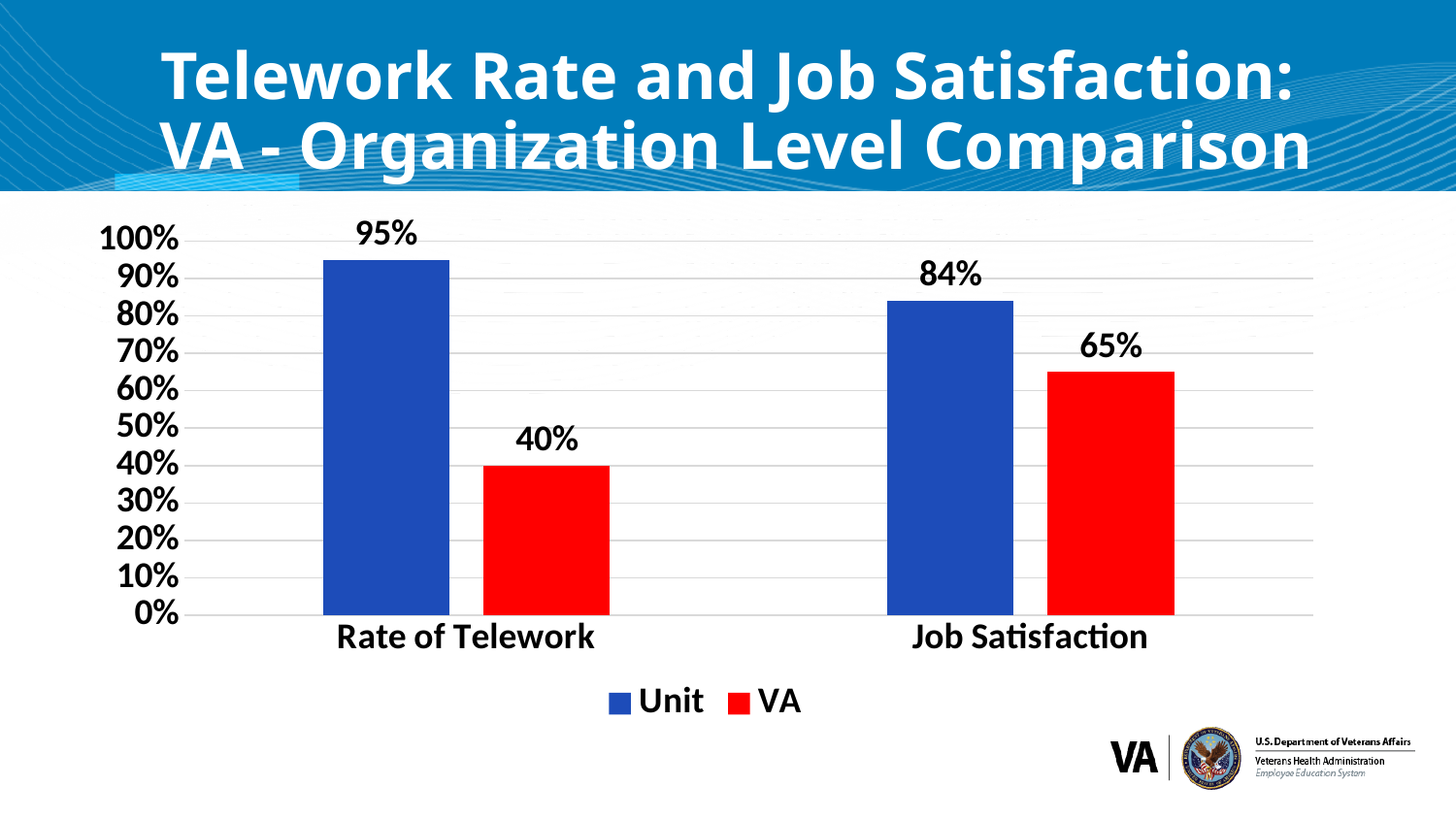
How many categories are shown on the x axis? 2 What is the difference between the Unit and VA values for Job Satisfaction? 19% What is the difference between the Unit and VA values for Rate of Telework? 55% What is the Unit value for Rate of Telework? 95% What is the VA value for Job Satisfaction? 65% What is the Unit value for Job Satisfaction? 84% Which is larger for Job Satisfaction, the Unit value or the VA value? Unit What is the VA value for Rate of Telework? 40% Which category has the highest VA value? Job Satisfaction Which category has the lowest Unit value? Job Satisfaction How many series does the legend list? 2 What kind of chart is shown on the slide? Bar chart